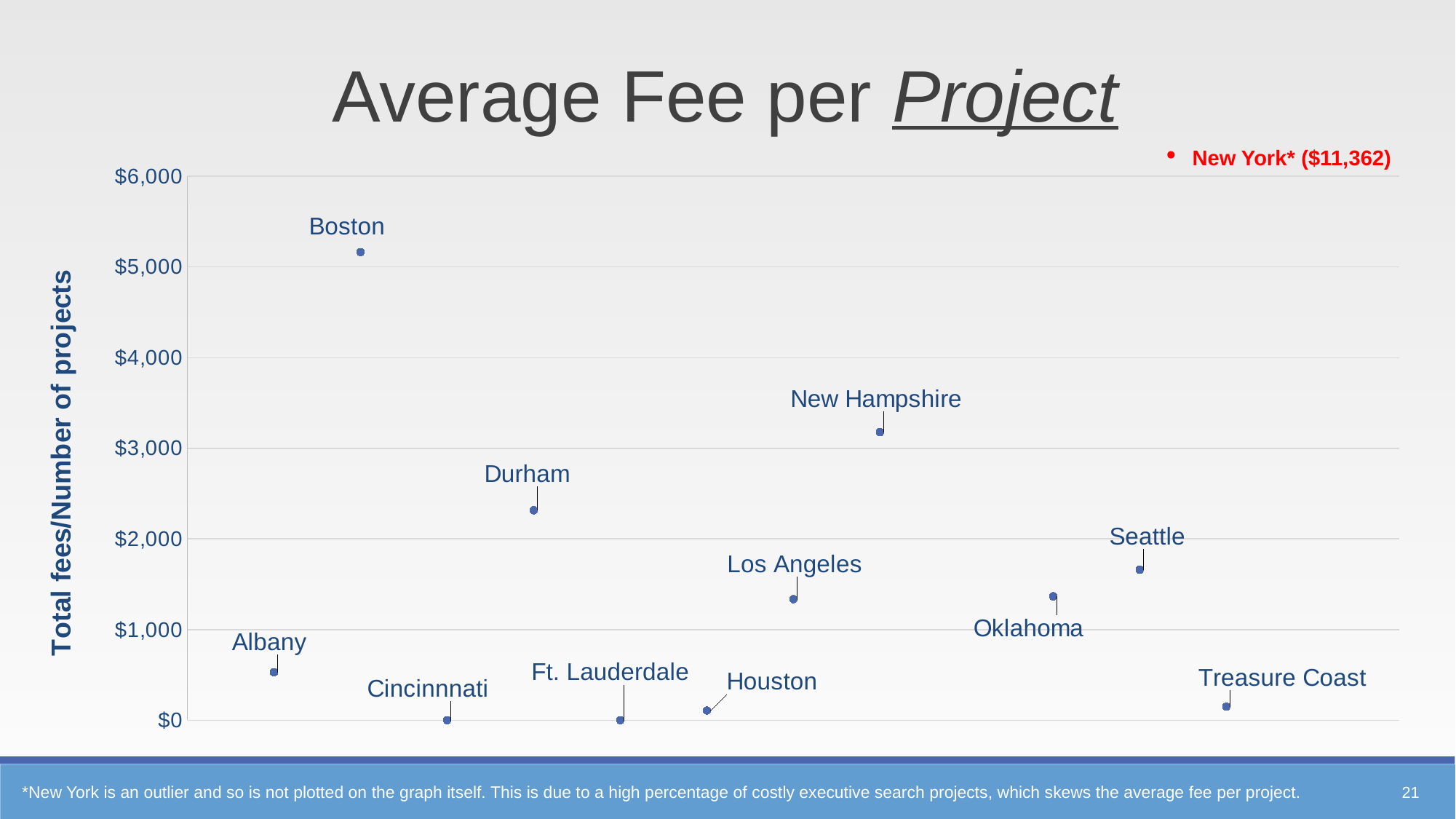
Is the value for Durham greater or less than $2,000? greater What kind of chart is shown on the slide? Scatter chart Which has a higher average fee per project, Durham or Seattle? Durham Is the value for New Hampshire greater or less than $3,000? greater Which plotted city has the highest average fee per project? Boston Is the value for Seattle greater or less than $2,000? less How many cities are plotted as points on the chart? 11 What is the average fee per project for New York, as noted on the slide? $11,362 Which has a higher average fee per project, Boston or New Hampshire? Boston What is the title of the vertical axis? Total fees/Number of projects